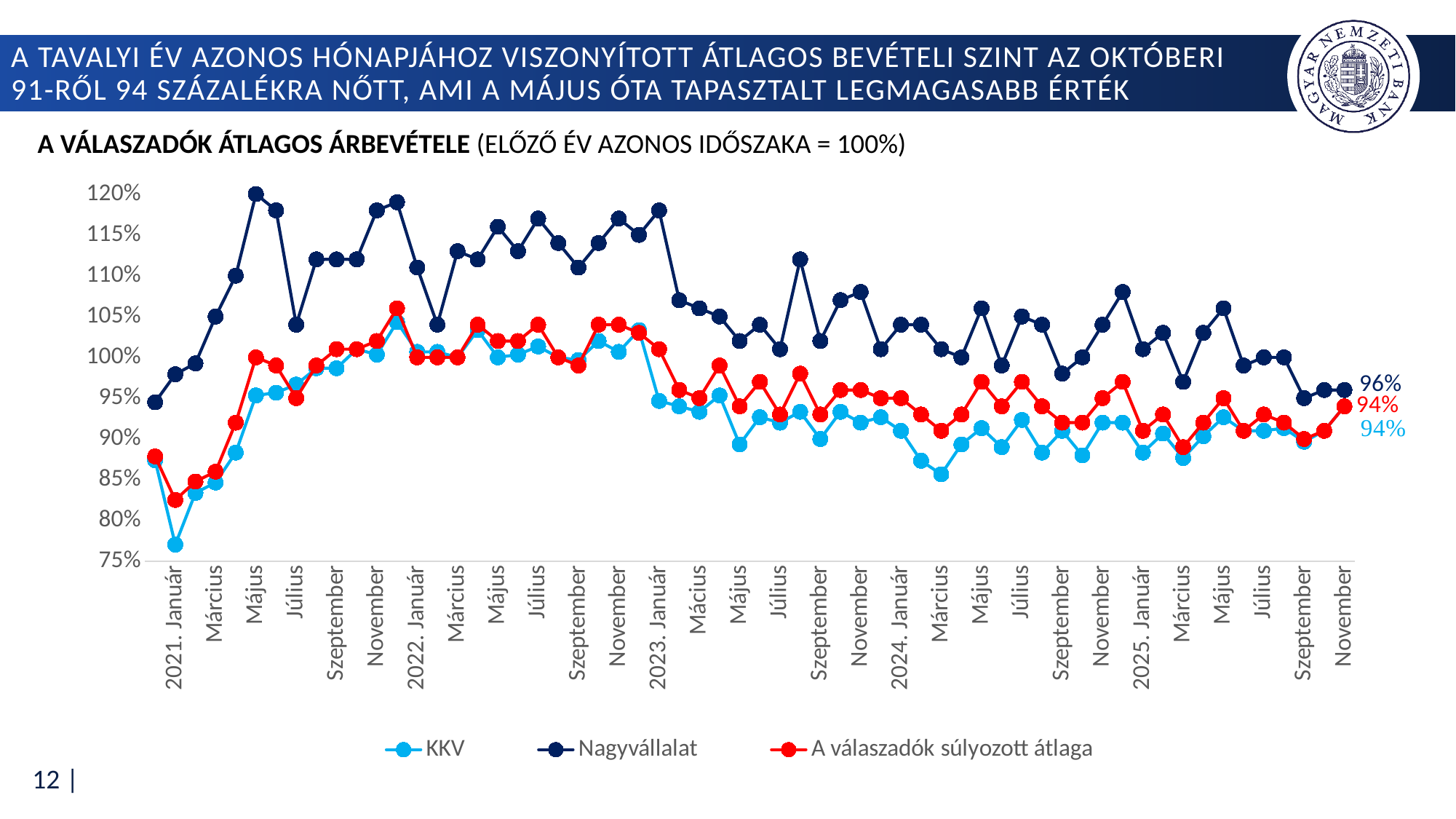
Which series has the highest value at the last point (2025 November)? Nagyvállalat What is the value of the KKV series at the last point (2025 November)? 94% Is the KKV value at 2021. Január greater or less than 80%? less Which series has the lowest value at 2021. Január? KKV What type of chart is shown on the slide? line chart What is the value of the Nagyvállalat series at the last point (2025 November)? 96% How many series does the legend list? 3 At the last point (2025 November), what is the difference between the Nagyvállalat value and the KKV value? 2 percentage points At the last point (2025 November), which series is higher: Nagyvállalat or KKV? Nagyvállalat What is the value of 'A válaszadók súlyozott átlaga' at the last point (2025 November)? 94% What are the three series named in the legend? KKV, Nagyvállalat, A válaszadók súlyozott átlaga Is the Nagyvállalat value at Május 2021 greater or less than 115%? greater